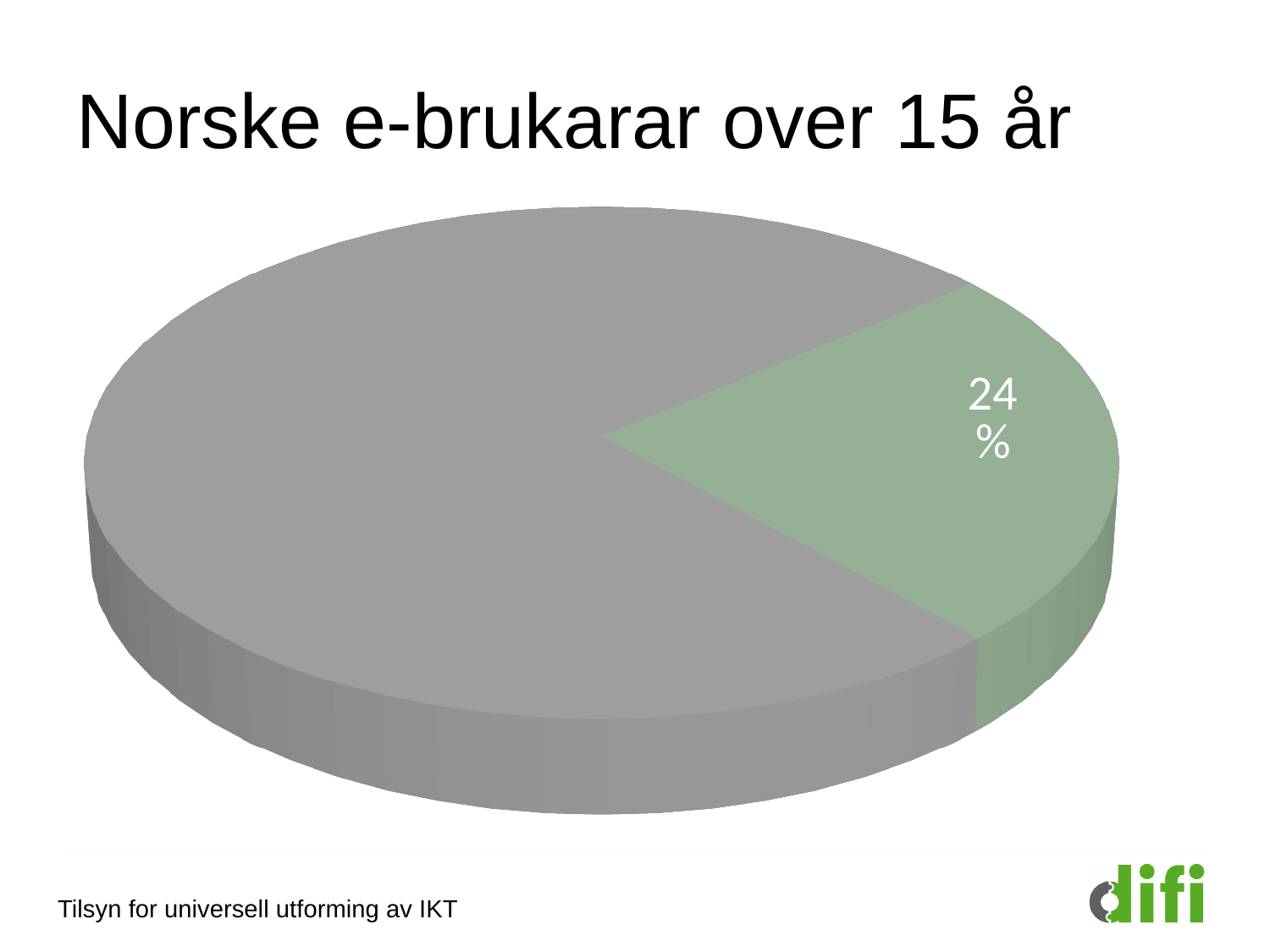
What value is printed on the green slice of the pie chart? 24 % What is the title of the slide containing the pie chart? Norske e-brukarar over 15 år Which slice of the pie chart is the smallest? the green slice What colour is the slice labelled 24 % in the pie chart? green What kind of chart is shown on the slide? pie chart What share of the pie does the green slice represent? 24 % How many slices does the pie chart have? 2 Which slice of the pie chart is larger, the grey one or the green one? the grey one Is the green slice of the pie chart greater or less than 50% of the pie? less Which slice of the pie chart is the largest? the grey slice